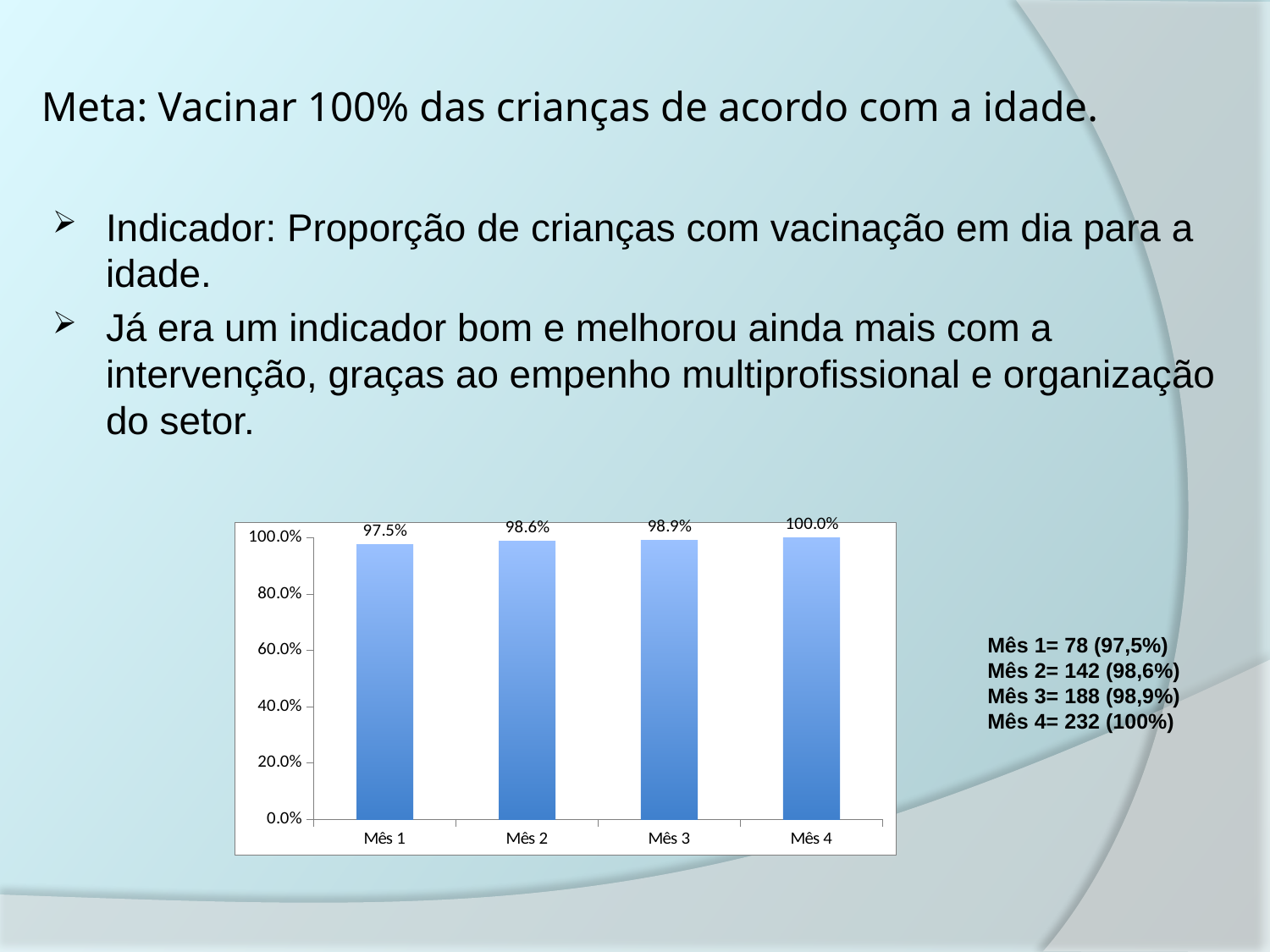
What is the difference between the values for Mês 4 and Mês 1? 2.5% What kind of chart is shown on the slide? Bar chart What is the difference between the values for Mês 2 and Mês 1? 1.1% How many categories are shown on the x axis? 4 What is the value for Mês 3? 98.9% Do the values rise or fall from Mês 1 to Mês 4? Rise Which month has the lowest value? Mês 1 Which is larger, the value for Mês 3 or the value for Mês 2? Mês 3 What is the value for Mês 1? 97.5% Which month has the highest value? Mês 4 What is the value for Mês 2? 98.6% What is the value for Mês 4? 100.0%